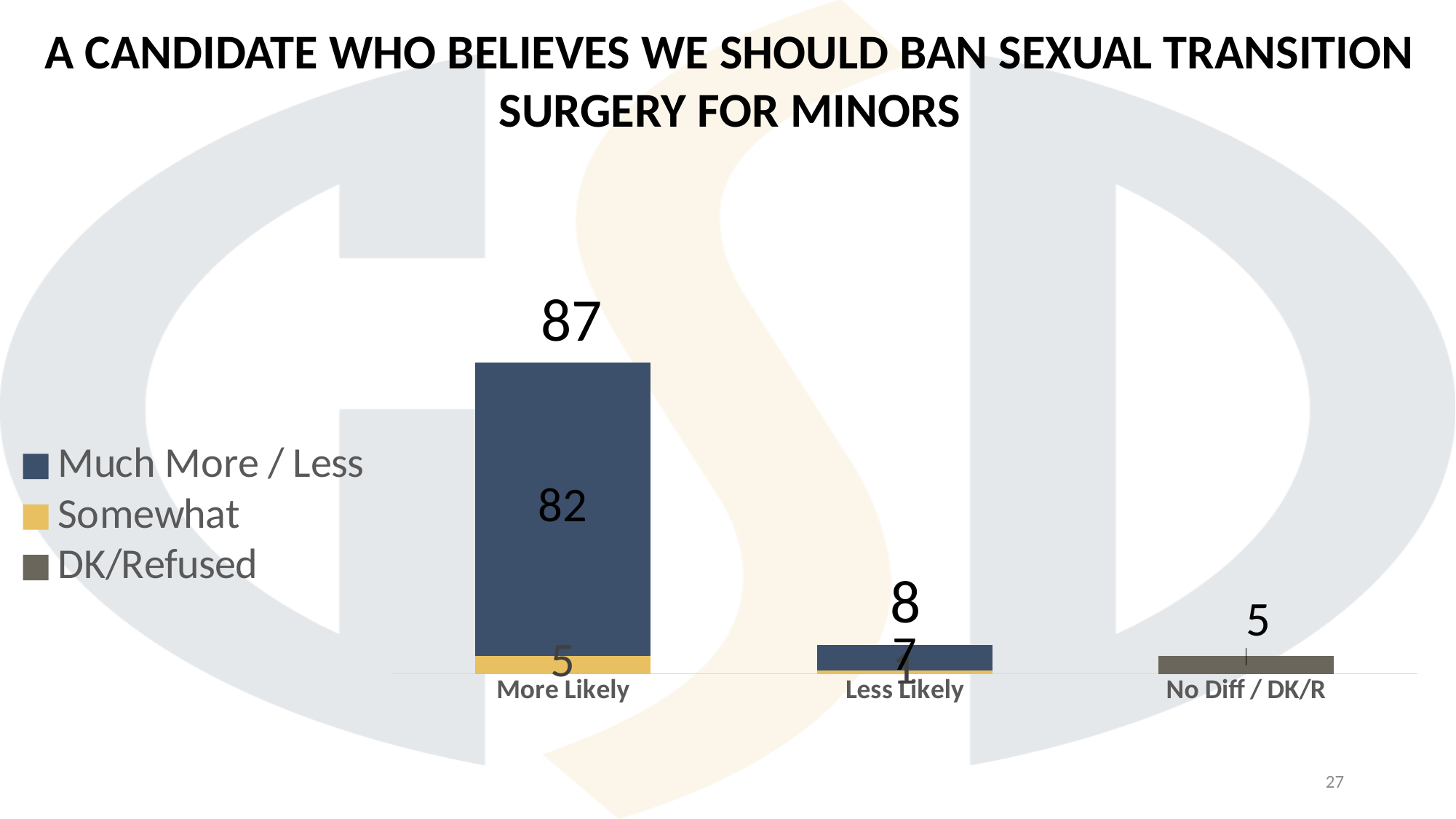
What is the value for No Diff / DK/R? 5 Which category has the highest total? More Likely What is the total value shown above the More Likely bar? 87 What is the Somewhat value for More Likely? 5 What is the difference between the More Likely total and the Less Likely total? 79 What is the Much More / Less value for More Likely? 82 What is the total value shown above the Less Likely bar? 8 How many categories are shown on the x axis? 3 What kind of chart is shown on the slide? Stacked bar chart How many series does the legend list? 3 What is the Much More / Less value for Less Likely? 7 Which category has the lowest total? No Diff / DK/R